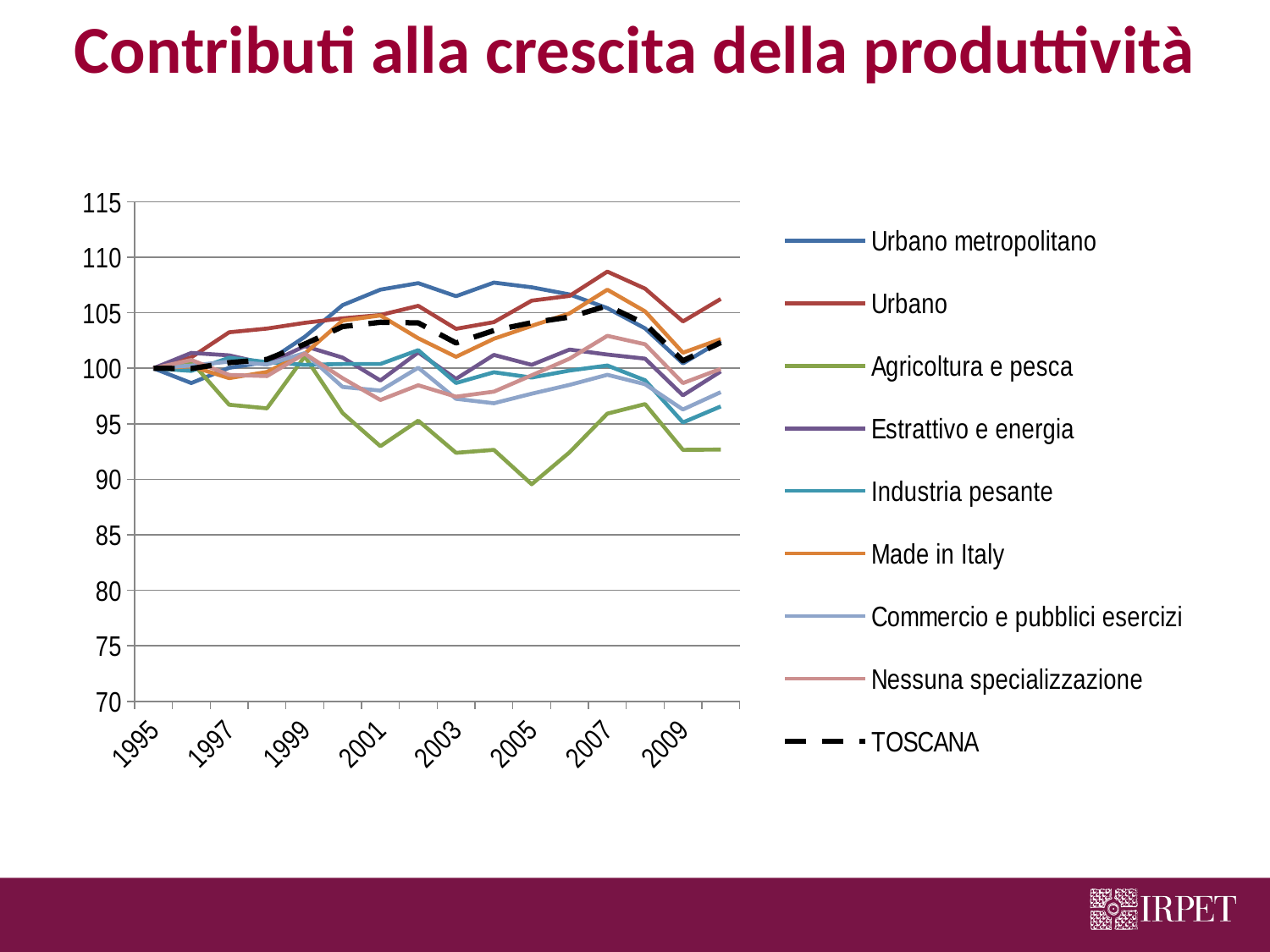
Is the value for Agricoltura e pesca in 2005 greater or less than 95? less Does the Agricoltura e pesca line rise or fall overall from 1995 to the end of the series? fall What value do all the series share in 1995? 100 How many year labels are shown on the x axis? 8 In 2007, which is higher: Urbano or Urbano metropolitano? Urbano What is the title of the slide? Contributi alla crescita della produttività Is the value for Urbano metropolitano in 2001 greater or less than 105? greater Which series is drawn as a dashed black line in the legend? TOSCANA Is the value for Urbano in 2007 greater or less than 105? greater What kind of chart is shown on the slide? line chart Which series reaches the lowest value on the chart? Agricoltura e pesca How many series does the legend list? 9